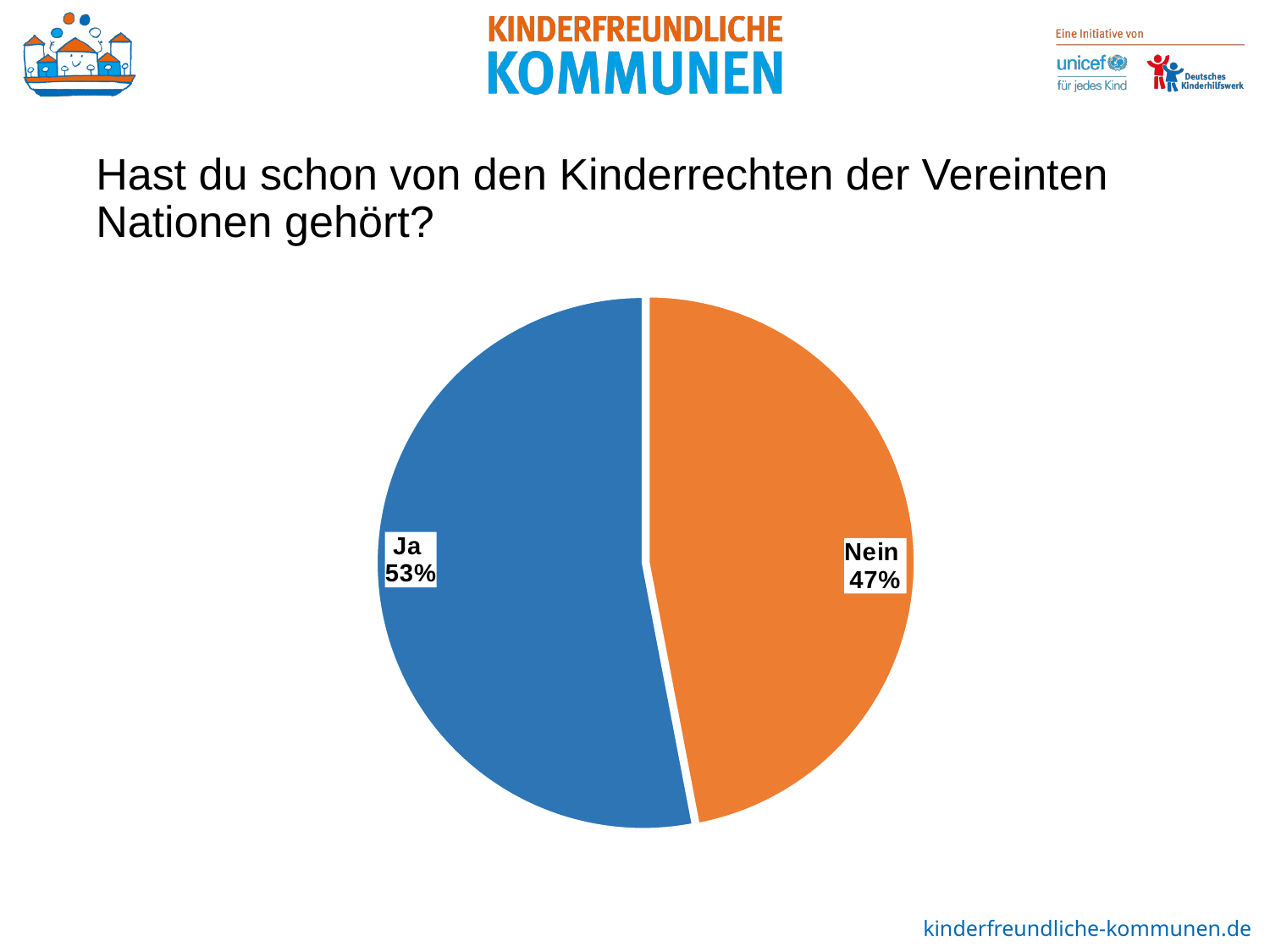
How many slices does the pie chart have? 2 What is the difference in percentage points between the "Ja" and "Nein" slices? 6 What colour is the "Nein" slice? orange What percentage of respondents answered "Ja"? 53% Which answer has the larger share of the pie? Ja What kind of chart is shown on the slide? pie chart What colour is the "Ja" slice? blue What percentage of respondents answered "Nein"? 47% Is the share for "Ja" larger or smaller than the share for "Nein"? larger Which answer has the smaller share of the pie? Nein What share of the pie does the "Nein" slice represent? 47%